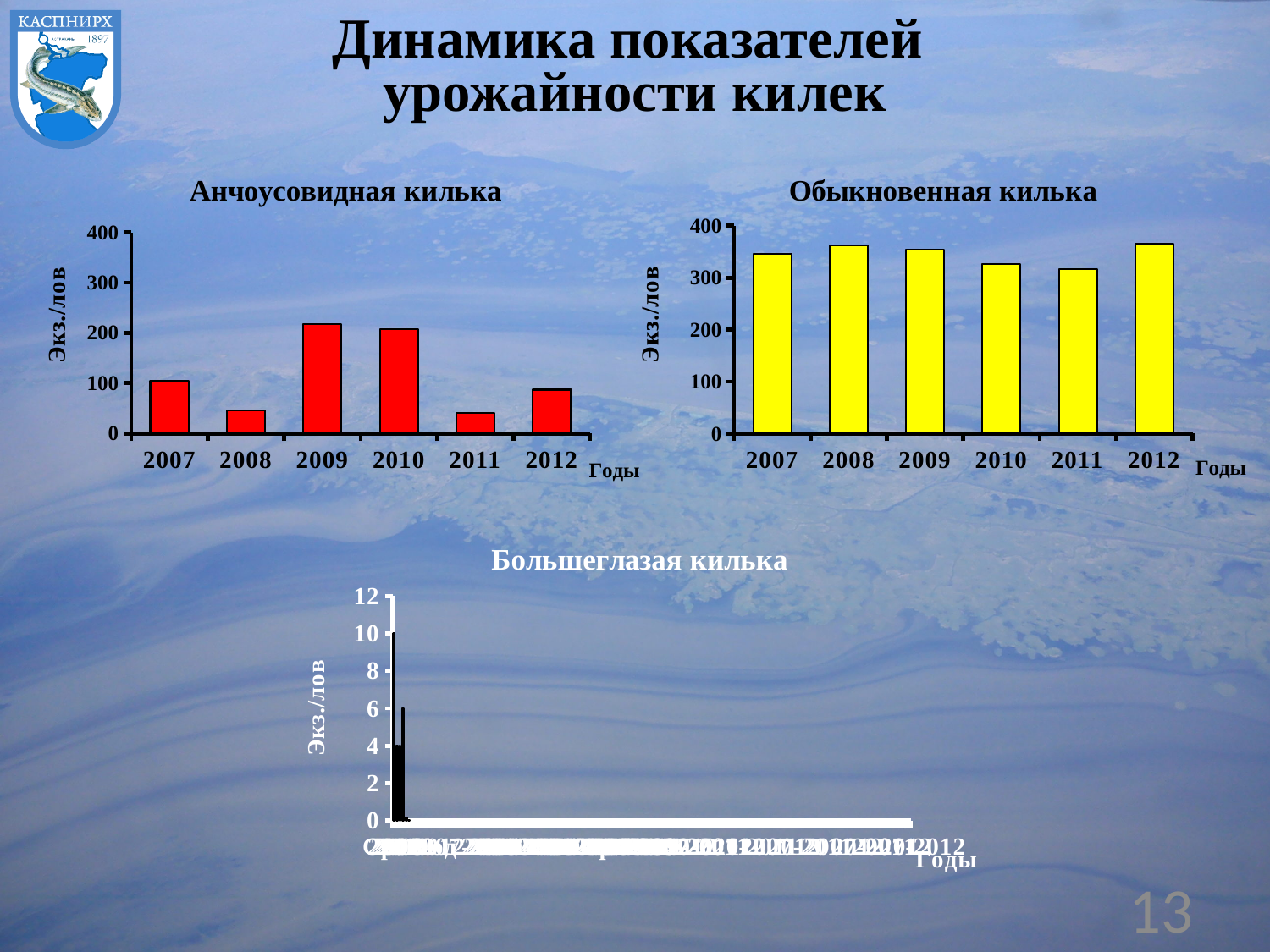
In the "Обыкновенная килька" chart, which is larger, the value for 2008 or the value for 2011? 2008 In the "Обыкновенная килька" chart, is the value for 2011 greater or less than 300? greater In the "Анчоусовидная килька" chart, which is larger, the value for 2009 or the value for 2008? 2009 How many years are shown on the x axis of the "Анчоусовидная килька" chart? 6 In the "Анчоусовидная килька" chart, is the value for 2009 greater or less than 200? greater How many years are shown on the x axis of the "Обыкновенная килька" chart? 6 What colour are the bars in the "Обыкновенная килька" chart? yellow In the "Обыкновенная килька" chart, is the value for 2012 greater or less than 400? less In the "Анчоусовидная килька" chart, which is larger, the value for 2010 or the value for 2011? 2010 What kind of chart is the "Анчоусовидная килька" chart? bar chart